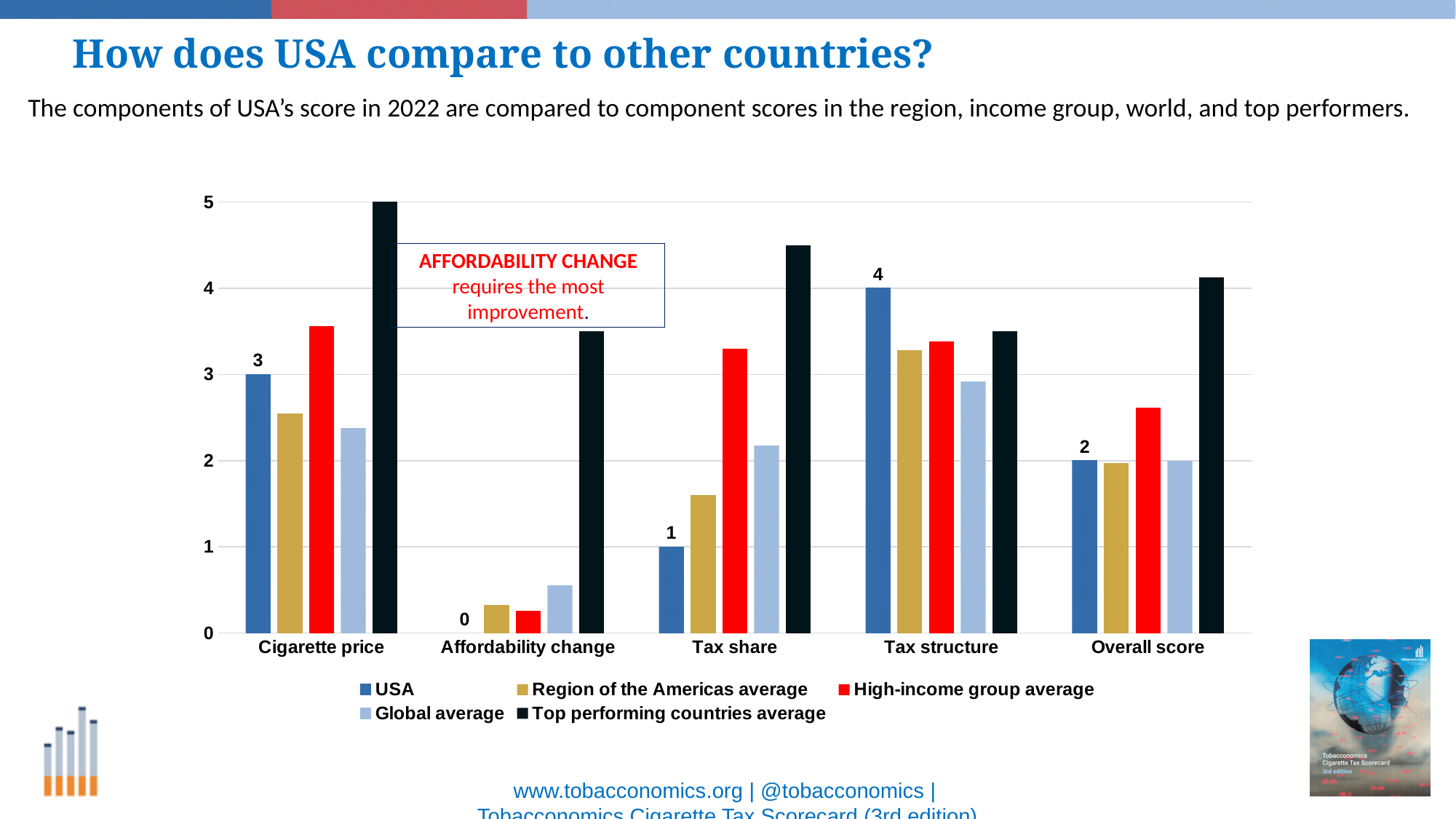
How many series does the legend list? 5 In which component does the USA have its highest score? Tax structure What is the difference between the USA's Tax structure score and its Tax share score? 3 What is the Top performing countries average for Cigarette price? 5 How many components (categories) are shown on the x axis? 5 What is the USA's score for Cigarette price? 3 What is the USA's Overall score? 2 What is the USA's score for Affordability change? 0 What is the USA's score for Tax structure? 4 In which component does the USA have its lowest score? Affordability change Is the Top performing countries average for Tax share greater or less than 4? greater Which is larger for the USA: the Cigarette price score or the Overall score? Cigarette price